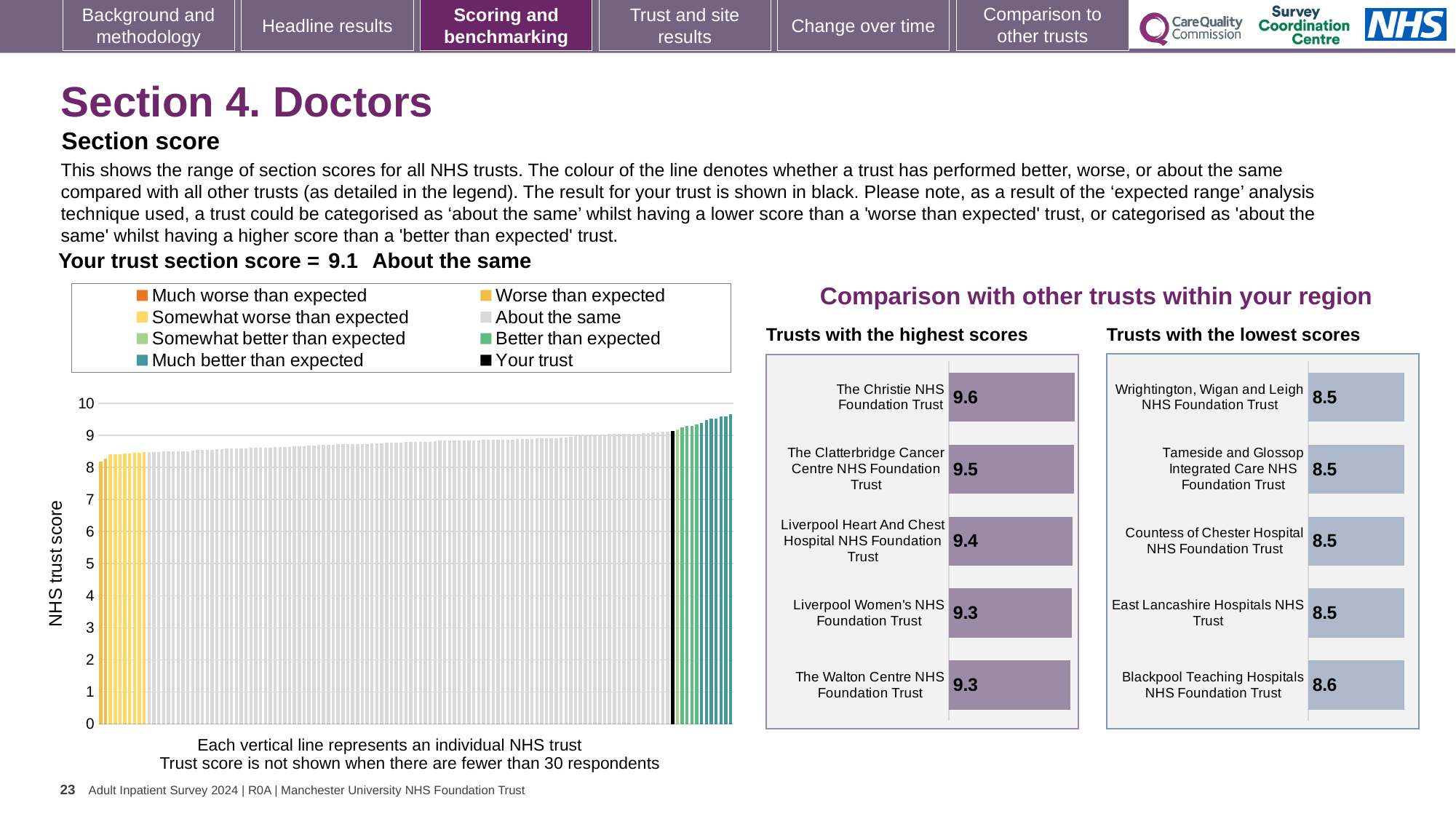
How many trusts are shown in the 'Trusts with the highest scores' chart? 5 What is the y-axis label of the large chart on the left showing all NHS trusts? NHS trust score In the 'Trusts with the highest scores' chart, which trust has the highest score? The Christie NHS Foundation Trust In the 'Trusts with the lowest scores' chart, what is the score for Countess of Chester Hospital NHS Foundation Trust? 8.5 In the large chart on the left, is the value for the lowest-scoring trust greater or less than 9? less What kind of chart is the 'Trusts with the lowest scores' chart? Bar chart In the 'Trusts with the lowest scores' chart, what is the score for Blackpool Teaching Hospitals NHS Foundation Trust? 8.6 In the 'Trusts with the highest scores' chart, which has the larger score: The Clatterbridge Cancer Centre NHS Foundation Trust or Liverpool Heart And Chest Hospital NHS Foundation Trust? The Clatterbridge Cancer Centre NHS Foundation Trust In the 'Trusts with the highest scores' chart, what is the score for The Christie NHS Foundation Trust? 9.6 In the 'Trusts with the highest scores' chart, what is the difference between the scores of The Christie NHS Foundation Trust and The Walton Centre NHS Foundation Trust? 0.3 In the 'Trusts with the lowest scores' chart, which trust has the highest score? Blackpool Teaching Hospitals NHS Foundation Trust How many entries does the legend of the large chart on the left list? 8